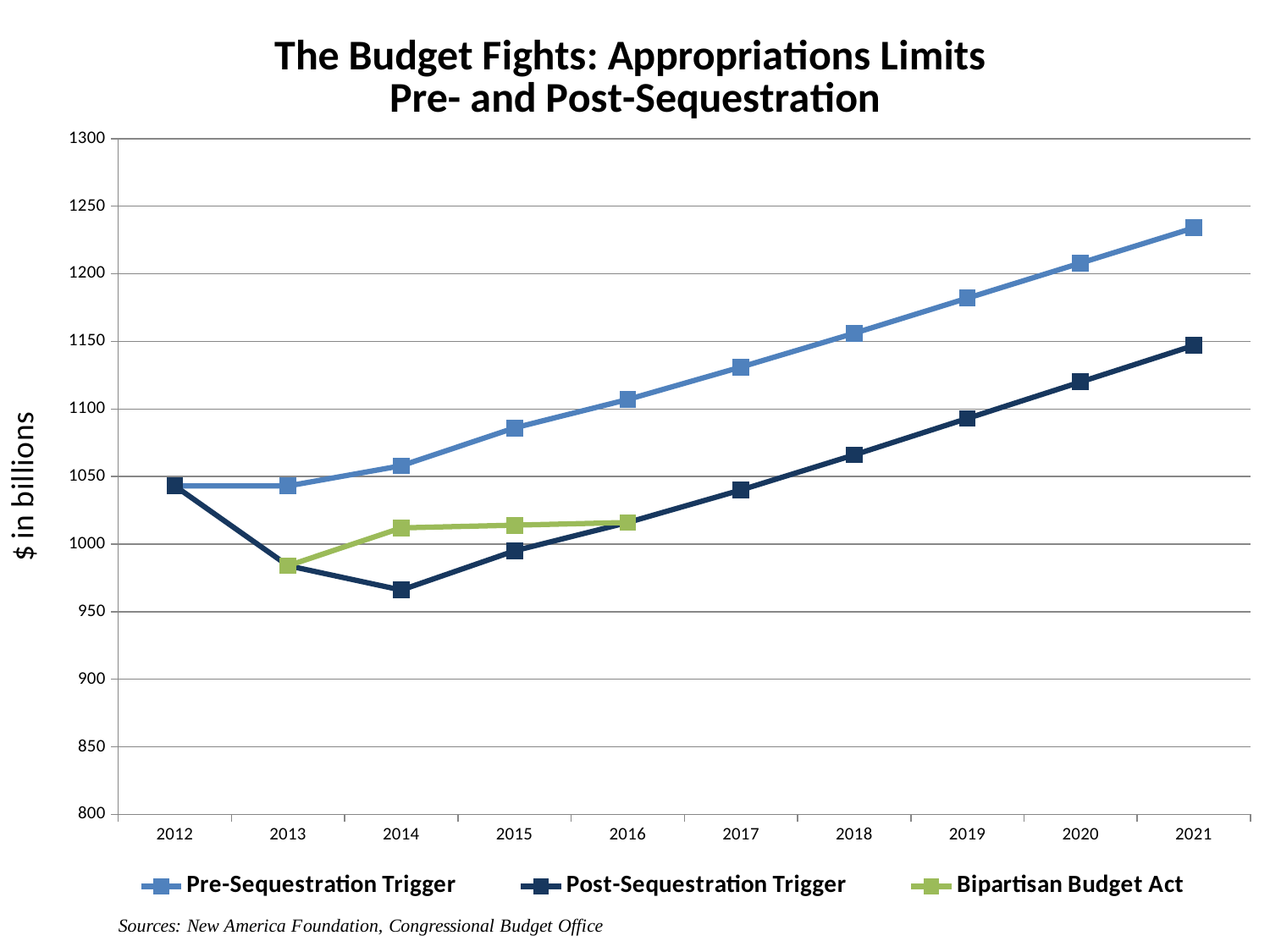
In which year does the Pre-Sequestration Trigger series reach its highest value? 2021 Does the Pre-Sequestration Trigger series rise or fall from 2013 to 2021? rise Is the Post-Sequestration Trigger value for 2014 greater or less than 1000? less Is the Bipartisan Budget Act value for 2013 greater or less than 1000? less In which year does the Post-Sequestration Trigger series reach its lowest value? 2014 What kind of chart is shown on the slide? line chart How many years are shown on the x axis? 10 Is the Pre-Sequestration Trigger value for 2021 greater or less than 1200? greater How many series does the legend list? 3 What is the label on the y axis? $ in billions In 2018, which series has the higher value, Pre-Sequestration Trigger or Post-Sequestration Trigger? Pre-Sequestration Trigger How many data points does the Bipartisan Budget Act series have? 4